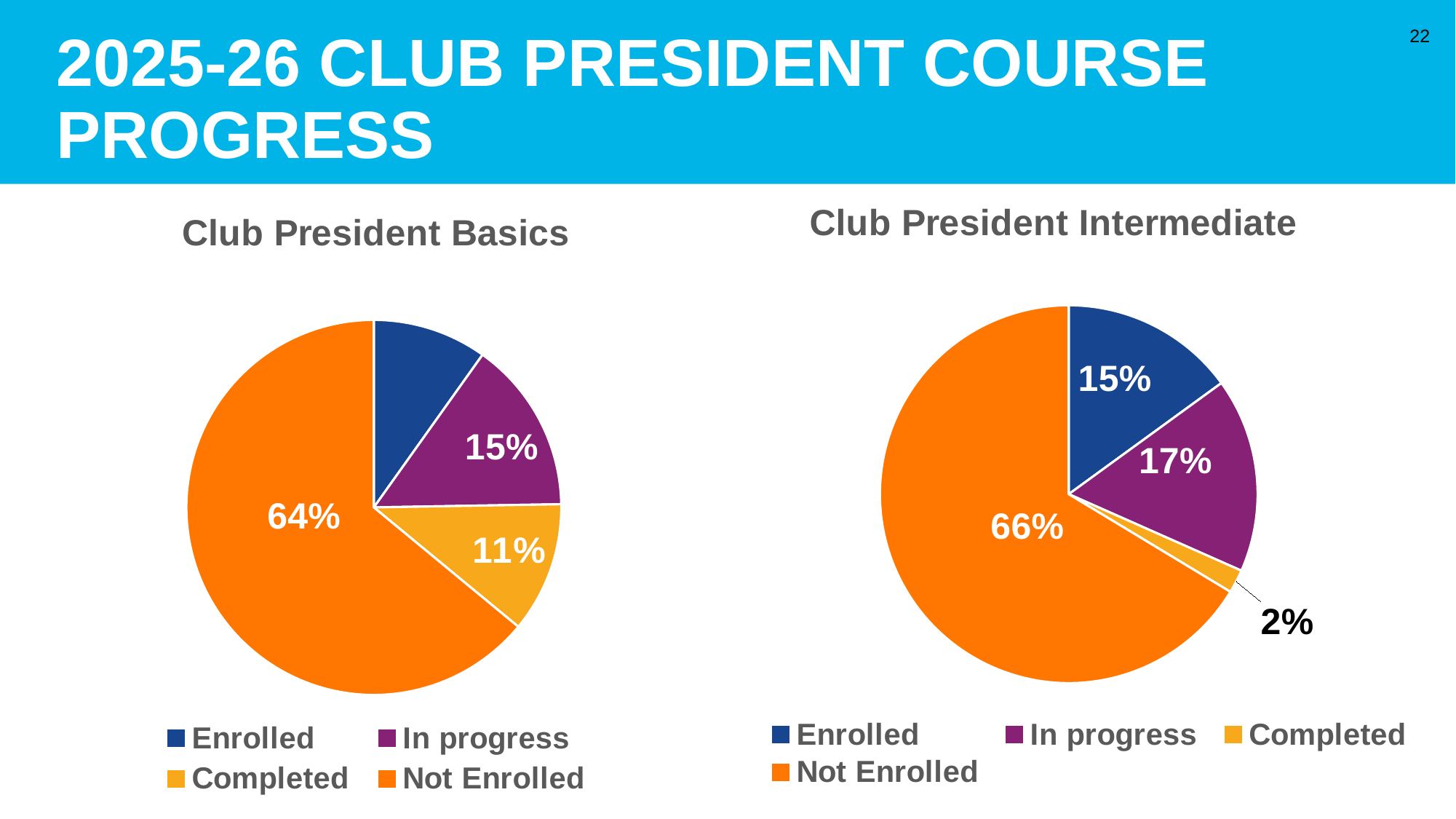
In the Club President Basics chart, what percentage is In progress? 15% In the Club President Intermediate chart, what percentage is Completed? 2% In the Club President Intermediate chart, what percentage is Not Enrolled? 66% In the Club President Intermediate chart, which is larger, Enrolled or In progress? In progress In the Club President Basics chart, what percentage is Completed? 11% In the Club President Basics chart, what percentage is Not Enrolled? 64% How many categories does the Club President Intermediate chart show? 4 In the Club President Intermediate chart, what is the difference in percentage points between Not Enrolled and In progress? 49 percentage points In the Club President Intermediate chart, which category has the smallest slice? Completed In the Club President Basics chart, which category has the largest slice? Not Enrolled What type of chart is the Club President Basics chart? Pie chart In the Club President Basics chart, what is the difference in percentage points between In progress and Completed? 4 percentage points